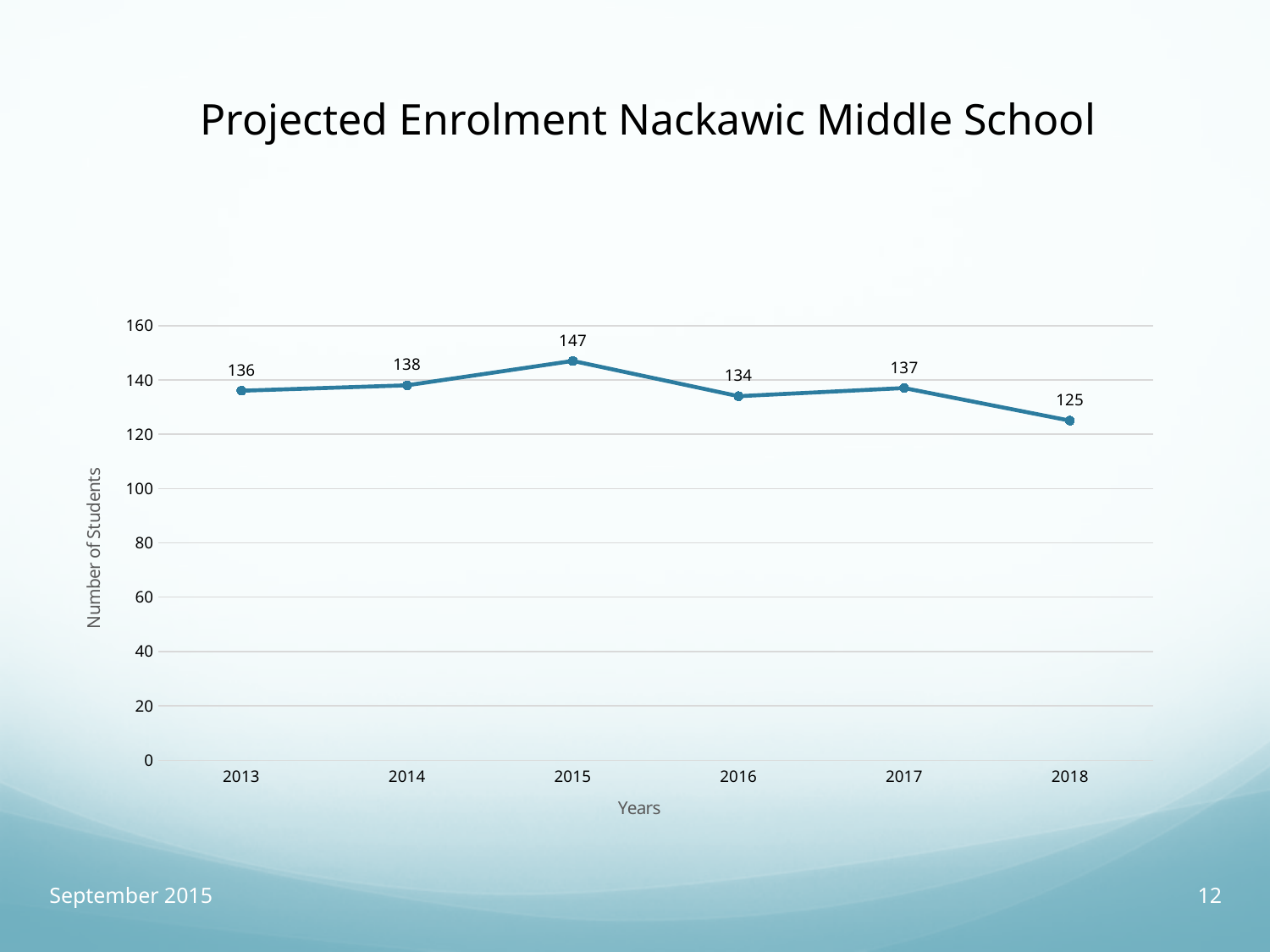
What is the difference between the projected enrolment in 2014 and in 2016? 4 What is the label of the y axis? Number of Students Which year has the lowest projected enrolment? 2018 What is the difference between the projected enrolment in 2015 and in 2018? 22 Which year has a larger projected enrolment, 2016 or 2017? 2017 What kind of chart is shown on the slide? line chart What is the projected enrolment for 2013? 136 How many years are plotted on the chart? 6 What is the projected enrolment for 2018? 125 Which year has the highest projected enrolment? 2015 Is the projected enrolment for 2018 greater or less than 140? less What is the projected enrolment for 2015? 147